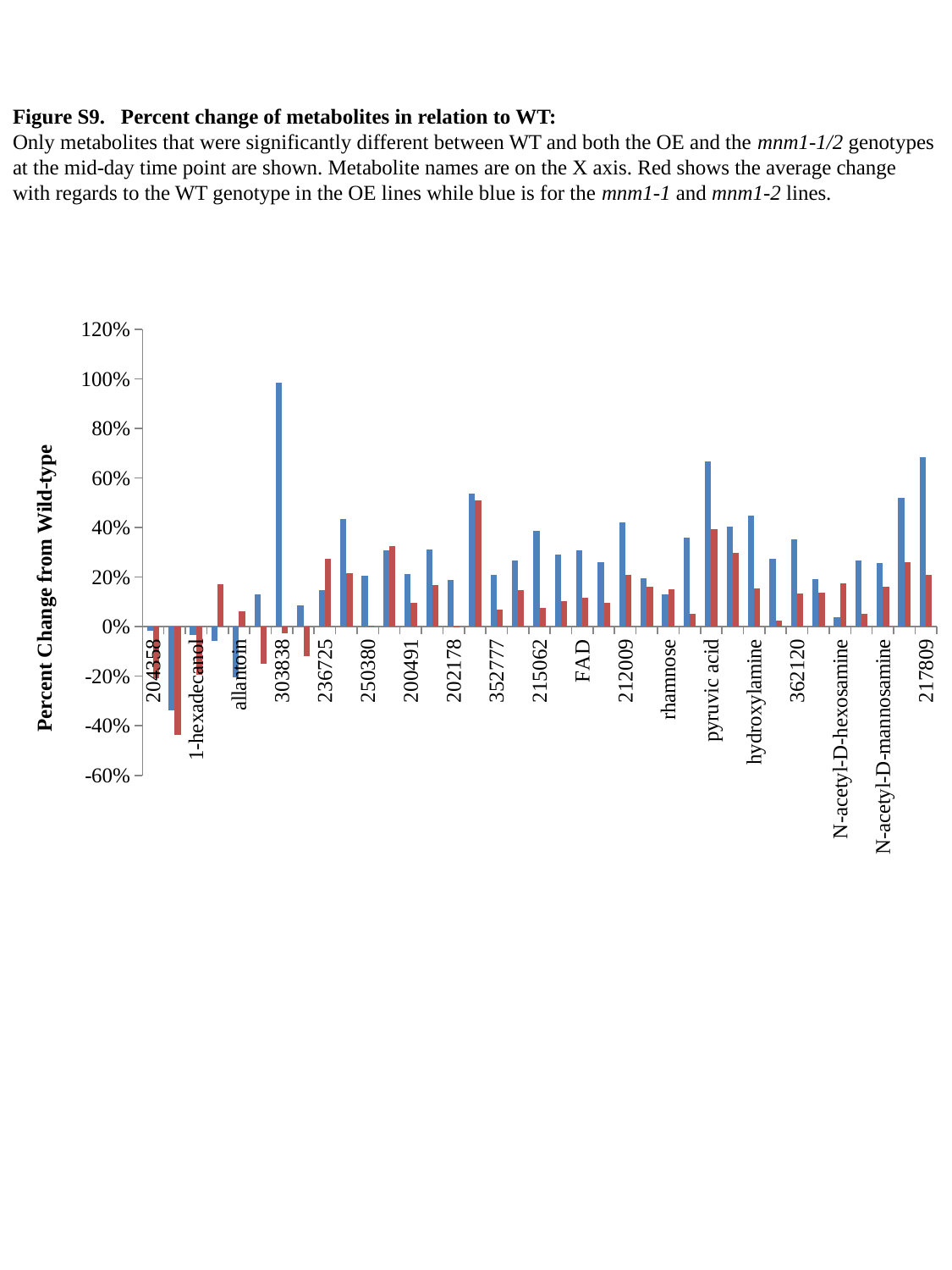
Is the blue bar for pyruvic acid greater or less than 60%? greater Which is larger, the blue bar for 303838 or the blue bar for pyruvic acid? 303838 Which metabolite has the tallest bar in the chart? 303838 Is the blue bar for 217809 greater or less than 60%? greater What is the highest value shown on the y axis? 120% Is the blue bar for 204358 above or below 0%? below What kind of chart is shown on the slide? bar chart What is the title of the y axis? Percent Change from Wild-type For 303838, which bar is larger, the blue bar or the red bar? blue